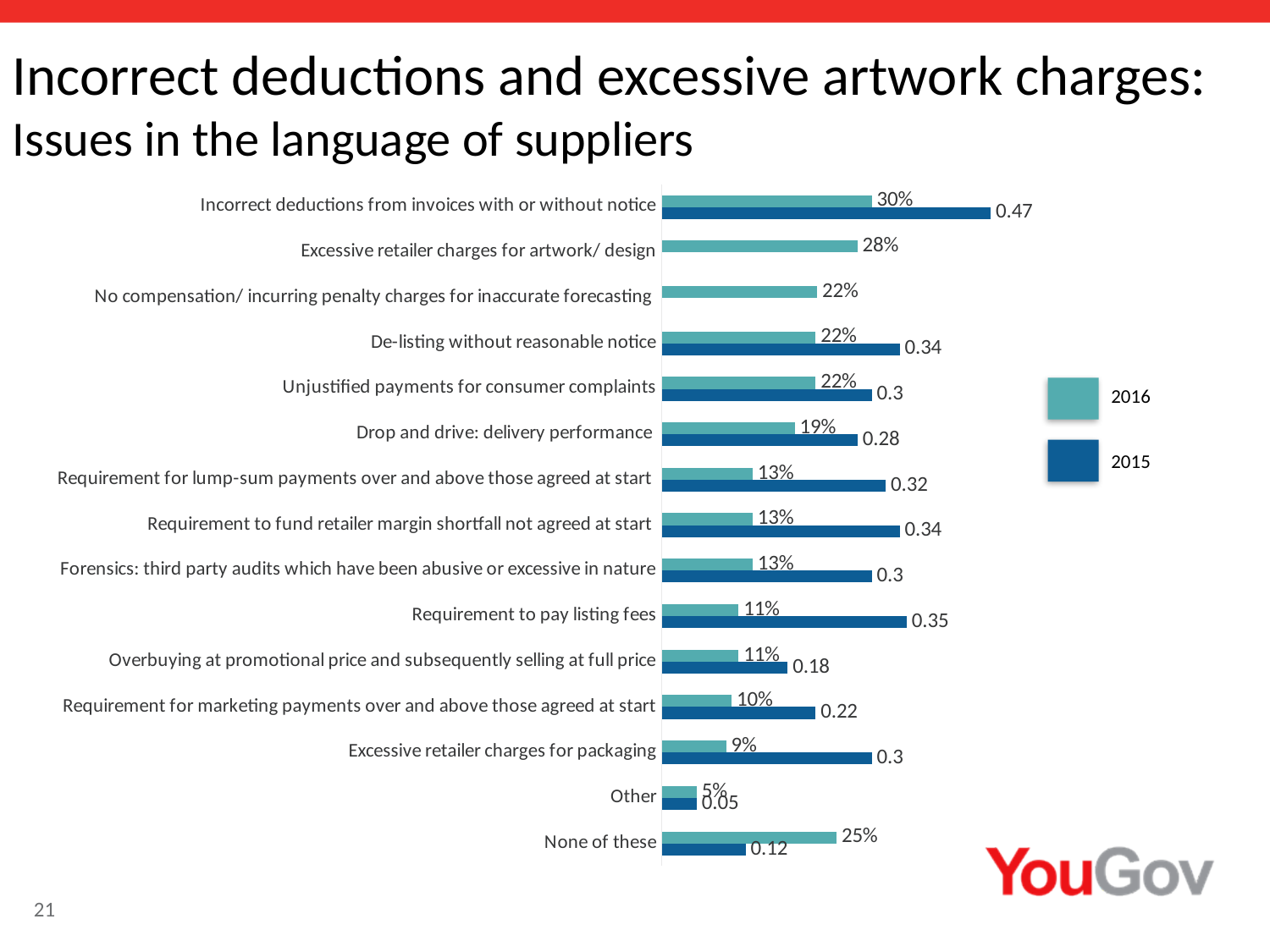
How many series does the legend list? 2 Which has the larger 2015 value: "De-listing without reasonable notice" or "Overbuying at promotional price and subsequently selling at full price"? De-listing without reasonable notice How many categories are shown on the chart? 15 What is the 2016 value for "Excessive retailer charges for packaging"? 9% What kind of chart is shown on the slide? Bar chart What is the difference between the 2016 values for "Excessive retailer charges for artwork/ design" and "Drop and drive: delivery performance"? 9% What is the 2015 value for "Incorrect deductions from invoices with or without notice"? 0.47 Which series is shown in dark blue according to the legend? 2015 What is the 2015 value for "Requirement to pay listing fees"? 0.35 What is the 2016 value for "Incorrect deductions from invoices with or without notice"? 30% Which category has the lowest 2016 value? Other Which category has the highest 2016 value? Incorrect deductions from invoices with or without notice